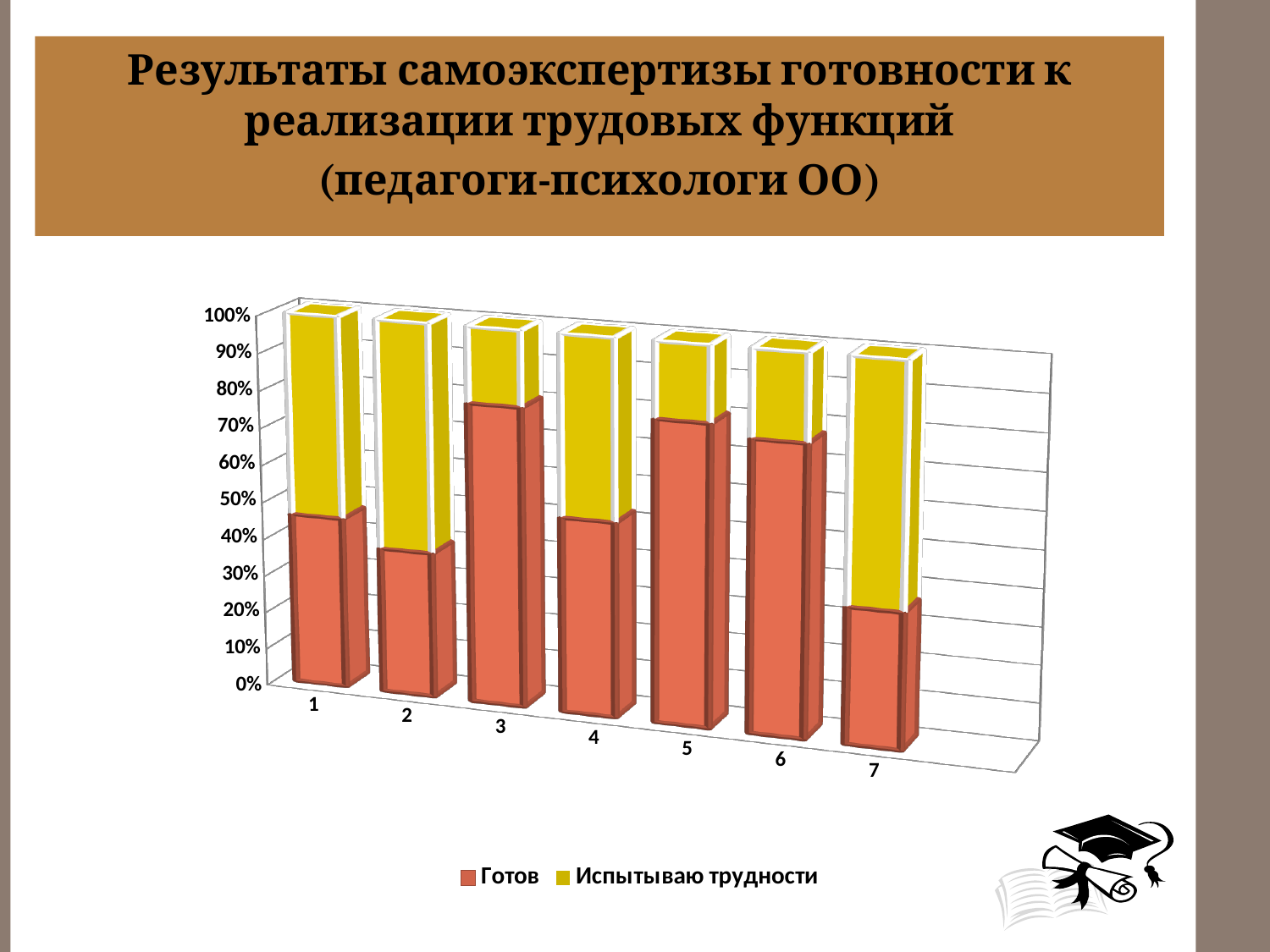
Which is larger for the series "Готов": category 3 or category 7? category 3 Which is larger for the series "Готов": category 6 or category 7? category 6 How many series does the chart legend list? 2 Which series is shown in yellow in the chart? Испытываю трудности What kind of chart is shown on the slide? bar chart Which category has the highest value for the series "Испытываю трудности"? 7 How many categories are shown along the x axis of the chart? 7 Is the value of "Готов" for category 3 greater or less than 60%? greater Which category has the lowest value for the series "Готов"? 7 Is the value of "Готов" for category 2 greater or less than 50%? less